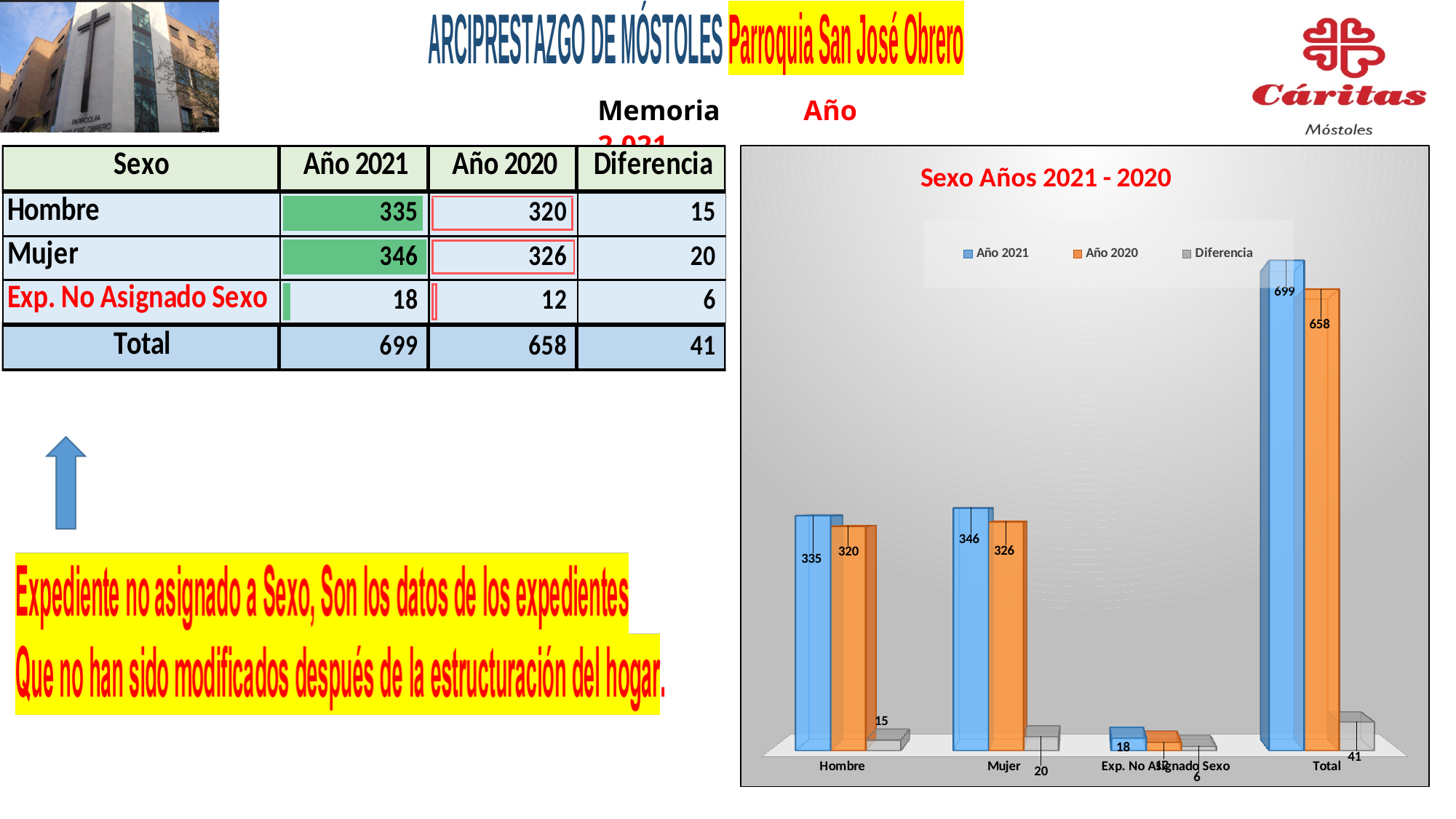
What is the Diferencia value for Total in the chart? 41 What kind of chart is shown on the slide? bar chart What is the difference between the Año 2021 and Año 2020 values for Hombre in the chart? 15 How many categories are shown on the x axis of the chart? 4 How many series does the chart legend list? 3 What is the title of the chart? Sexo Años 2021 - 2020 What is the Año 2020 value for Mujer in the chart? 326 Which category has the lowest Año 2020 value in the chart? Exp. No Asignado Sexo Which is larger in the chart, the Año 2021 value for Mujer or the Año 2021 value for Hombre? Mujer What is the Año 2021 value for Hombre in the chart? 335 Which category has the highest Año 2021 value in the chart? Total What is the Año 2021 value for Exp. No Asignado Sexo in the chart? 18